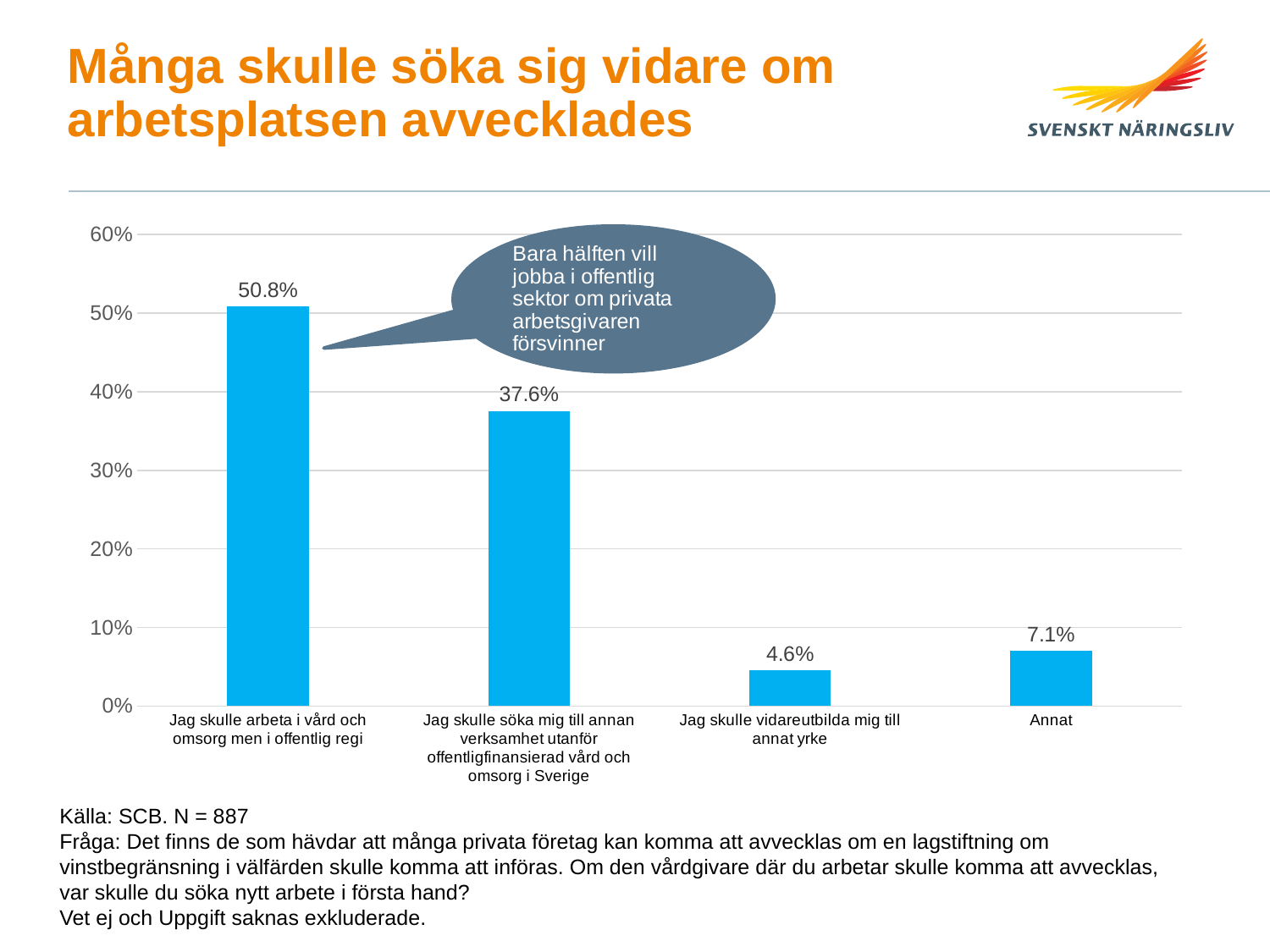
Which category has the lowest value? Jag skulle vidareutbilda mig till annat yrke How many categories are shown in the chart? 4 What kind of chart is shown on the slide? Bar chart What is the value for "Jag skulle vidareutbilda mig till annat yrke"? 4.6% What is the value for "Annat"? 7.1% What is the value for "Jag skulle arbeta i vård och omsorg men i offentlig regi"? 50.8% What is the difference between the values for "Jag skulle arbeta i vård och omsorg men i offentlig regi" and "Jag skulle söka mig till annan verksamhet utanför offentligfinansierad vård och omsorg i Sverige"? 13.2% Which is larger, the value for "Annat" or the value for "Jag skulle vidareutbilda mig till annat yrke"? Annat Which category has the highest value? Jag skulle arbeta i vård och omsorg men i offentlig regi What is the difference between the values for "Annat" and "Jag skulle vidareutbilda mig till annat yrke"? 2.5% What is the value for "Jag skulle söka mig till annan verksamhet utanför offentligfinansierad vård och omsorg i Sverige"? 37.6% What is the title of the slide? Många skulle söka sig vidare om arbetsplatsen avvecklades